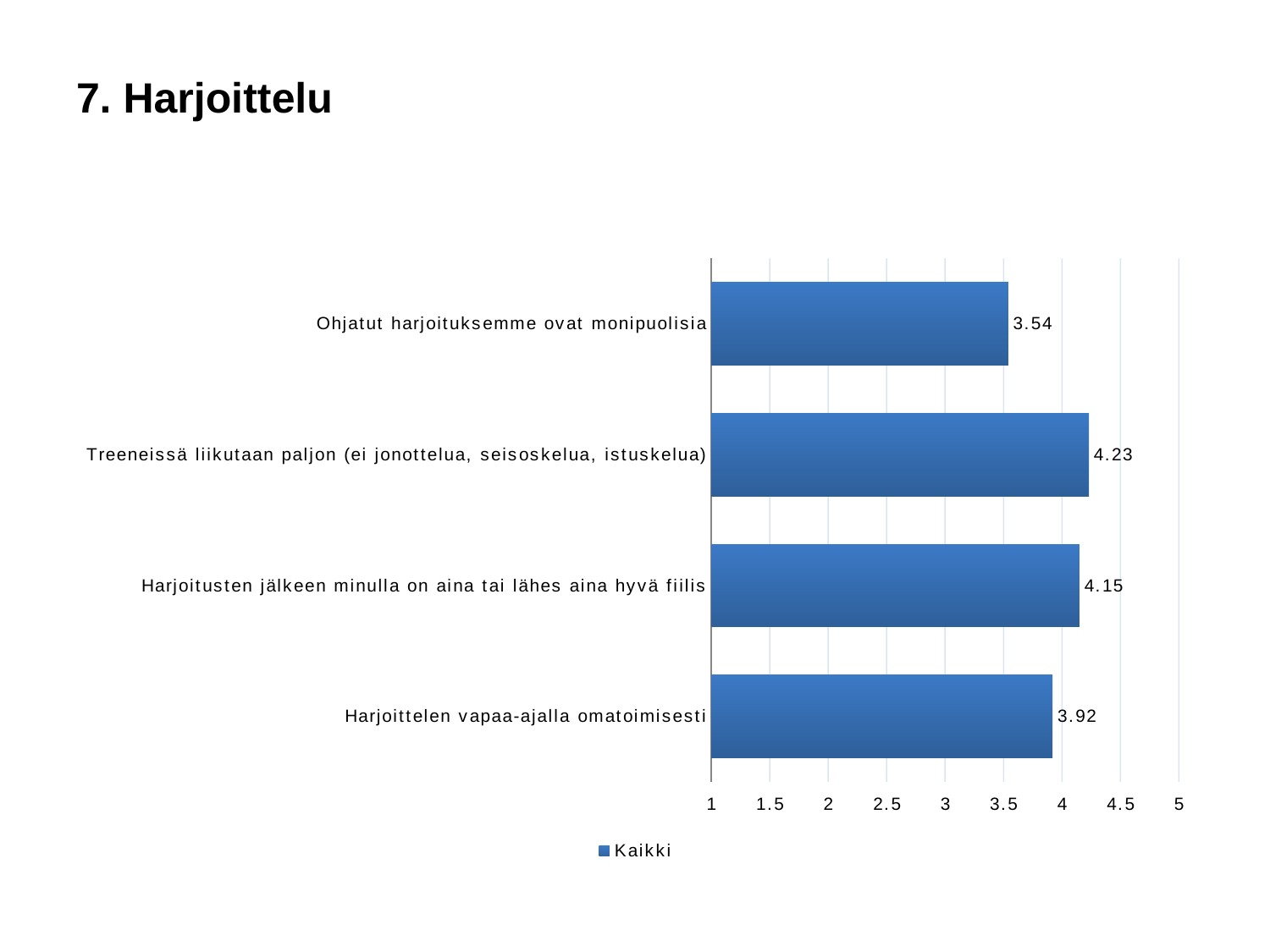
What is the value for "Harjoittelen vapaa-ajalla omatoimisesti"? 3.92 What is the name of the series in the legend? Kaikki Which category has the highest value? Treeneissä liikutaan paljon (ei jonottelua, seisoskelua, istuskelua) What is the value for "Ohjatut harjoituksemme ovat monipuolisia"? 3.54 How many series does the legend list? 1 Which is larger: the value for "Harjoittelen vapaa-ajalla omatoimisesti" or for "Harjoitusten jälkeen minulla on aina tai lähes aina hyvä fiilis"? Harjoitusten jälkeen minulla on aina tai lähes aina hyvä fiilis Which category has the lowest value? Ohjatut harjoituksemme ovat monipuolisia What kind of chart is shown on the slide? bar chart What is the value for "Harjoitusten jälkeen minulla on aina tai lähes aina hyvä fiilis"? 4.15 Is the value for "Harjoittelen vapaa-ajalla omatoimisesti" greater or less than 4? less How many categories are shown in the chart? 4 What is the difference between the values for "Treeneissä liikutaan paljon (ei jonottelua, seisoskelua, istuskelua)" and "Ohjatut harjoituksemme ovat monipuolisia"? 0.69